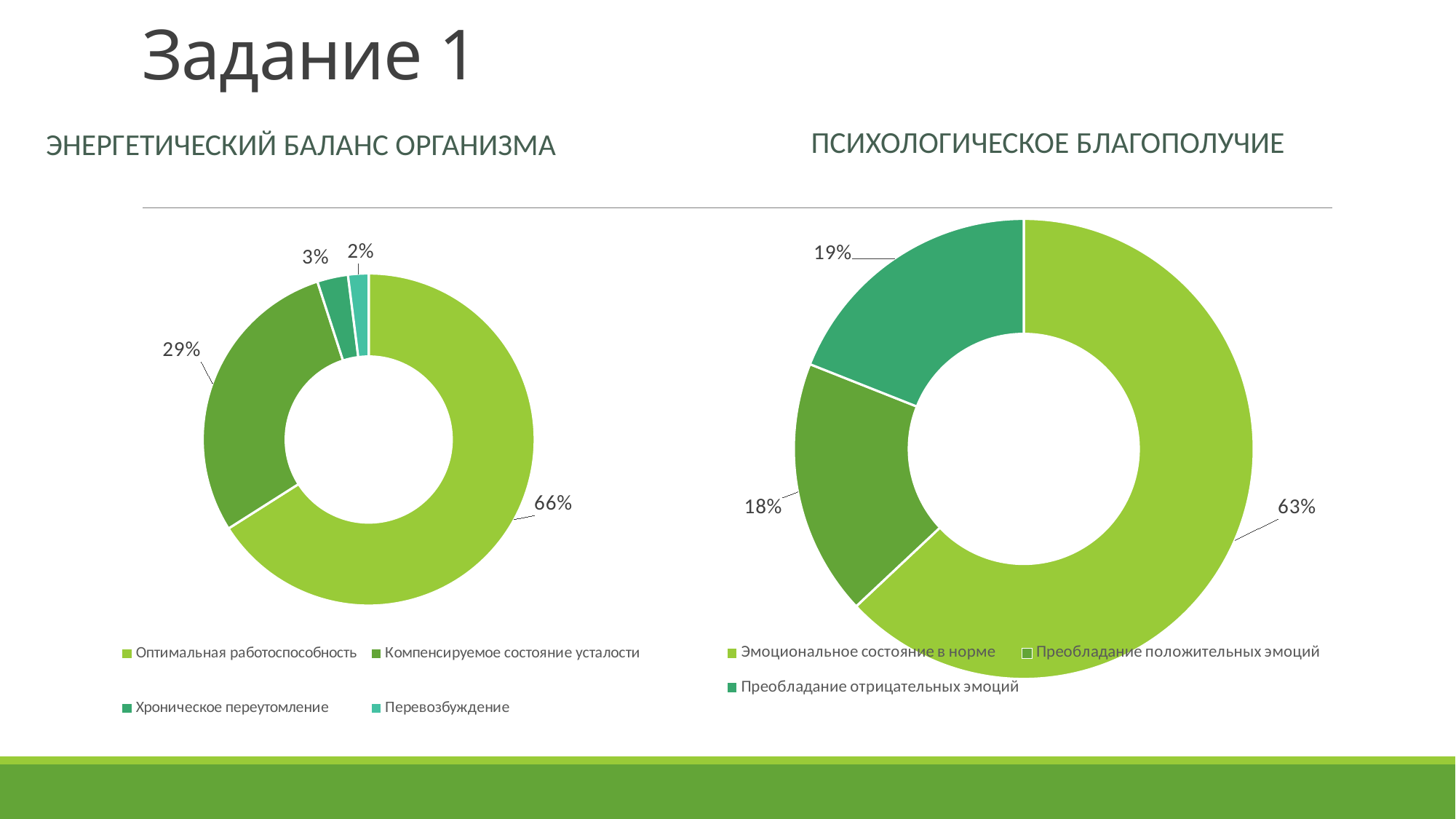
In the 'ЭНЕРГЕТИЧЕСКИЙ БАЛАНС ОРГАНИЗМА' chart, which category has the smallest share? Перевозбуждение In the 'ПСИХОЛОГИЧЕСКОЕ БЛАГОПОЛУЧИЕ' chart, what is the difference between 'Эмоциональное состояние в норме' and 'Преобладание отрицательных эмоций'? 44% In the 'ЭНЕРГЕТИЧЕСКИЙ БАЛАНС ОРГАНИЗМА' chart, how many categories are shown? 4 What type of chart is used for 'ЭНЕРГЕТИЧЕСКИЙ БАЛАНС ОРГАНИЗМА'? Doughnut (pie) chart In the 'ПСИХОЛОГИЧЕСКОЕ БЛАГОПОЛУЧИЕ' chart, what percentage is shown for 'Эмоциональное состояние в норме'? 63% In the 'ЭНЕРГЕТИЧЕСКИЙ БАЛАНС ОРГАНИЗМА' chart, what percentage is shown for 'Компенсируемое состояние усталости'? 29% In the 'ЭНЕРГЕТИЧЕСКИЙ БАЛАНС ОРГАНИЗМА' chart, what percentage is shown for 'Оптимальная работоспособность'? 66% Which is larger: 'Оптимальная работоспособность' in the left chart or 'Эмоциональное состояние в норме' in the right chart? Оптимальная работоспособность In the 'ПСИХОЛОГИЧЕСКОЕ БЛАГОПОЛУЧИЕ' chart, how many categories does the legend list? 3 In the 'ЭНЕРГЕТИЧЕСКИЙ БАЛАНС ОРГАНИЗМА' chart, what is the difference between 'Оптимальная работоспособность' and 'Компенсируемое состояние усталости'? 37% In the 'ПСИХОЛОГИЧЕСКОЕ БЛАГОПОЛУЧИЕ' chart, which category has the largest share? Эмоциональное состояние в норме In the 'ПСИХОЛОГИЧЕСКОЕ БЛАГОПОЛУЧИЕ' chart, what percentage is shown for 'Преобладание отрицательных эмоций'? 19%